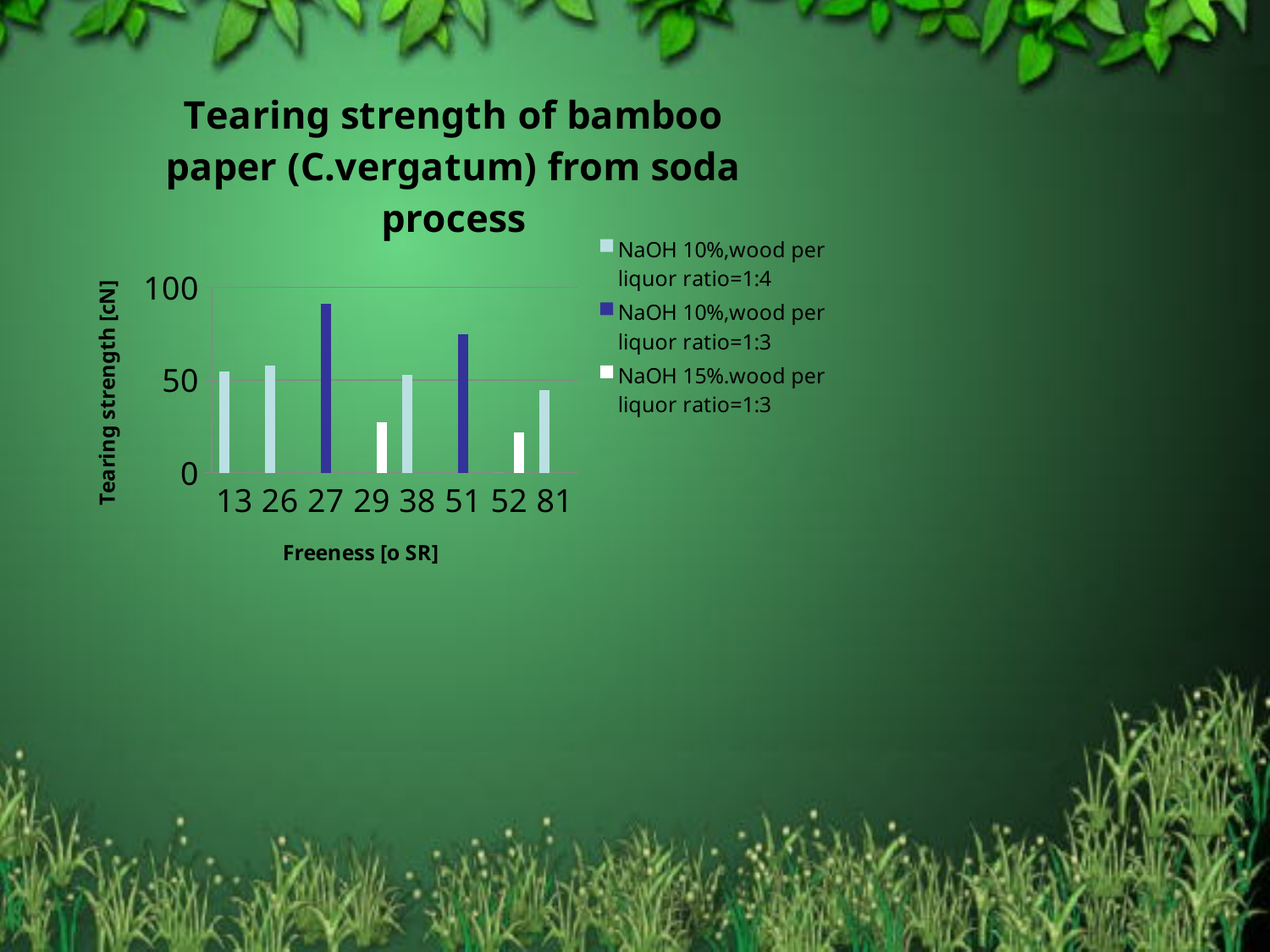
Is the tearing strength at freeness 27 greater or less than 50? greater What kind of chart is shown on the slide? bar chart Which has the larger tearing strength, freeness 27 or freeness 51? 27 Is the tearing strength at freeness 29 greater or less than 50? less Is the tearing strength at freeness 51 greater or less than 100? less What is the label of the y axis? Tearing strength [cN] Which freeness value has the highest tearing strength? 27 How many series does the legend list? 3 Which has the larger tearing strength, freeness 81 or freeness 52? 81 How many freeness categories are shown on the x axis? 8 Which freeness value has the lowest tearing strength? 52